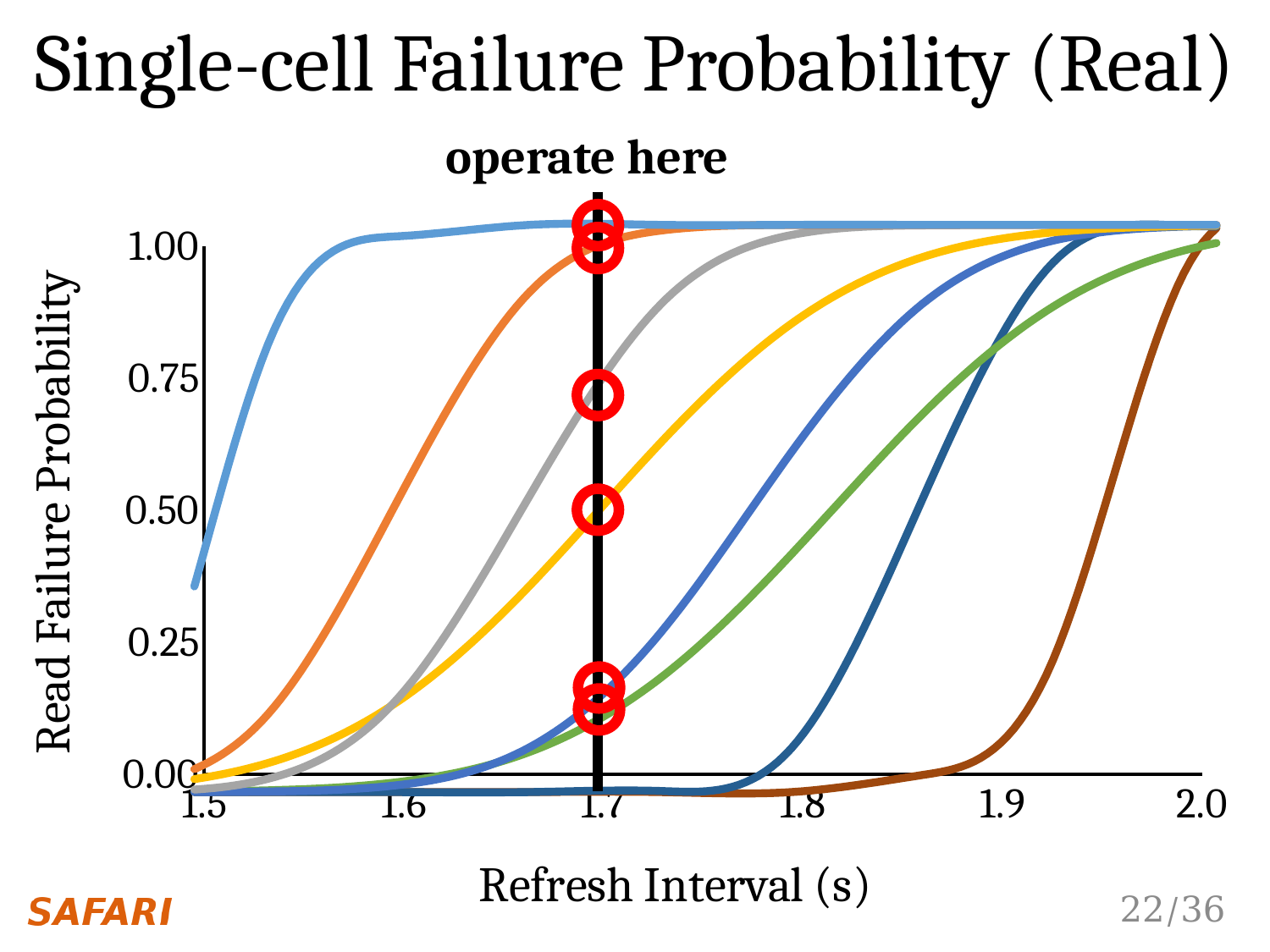
What is the title of the chart on the slide? Single-cell Failure Probability (Real) Is the value of the gray curve at a refresh interval of 1.7 greater or less than 0.50? greater What kind of chart is shown on the slide? line chart What is the label of the x axis of the chart? Refresh Interval (s) At what refresh interval is the vertical 'operate here' line drawn? 1.7 Is the value of the green curve at a refresh interval of 1.7 greater or less than 0.25? less How many curves are plotted on the chart? 8 At a refresh interval of 1.7, which curve has the larger read failure probability, the gray curve or the green curve? gray curve Is the value of the brown curve at a refresh interval of 1.7 greater or less than 0.25? less Do the curves rise or fall as the refresh interval increases along the x axis? rise Which curve is the last to rise toward a read failure probability of 1.00 as the refresh interval increases? brown curve